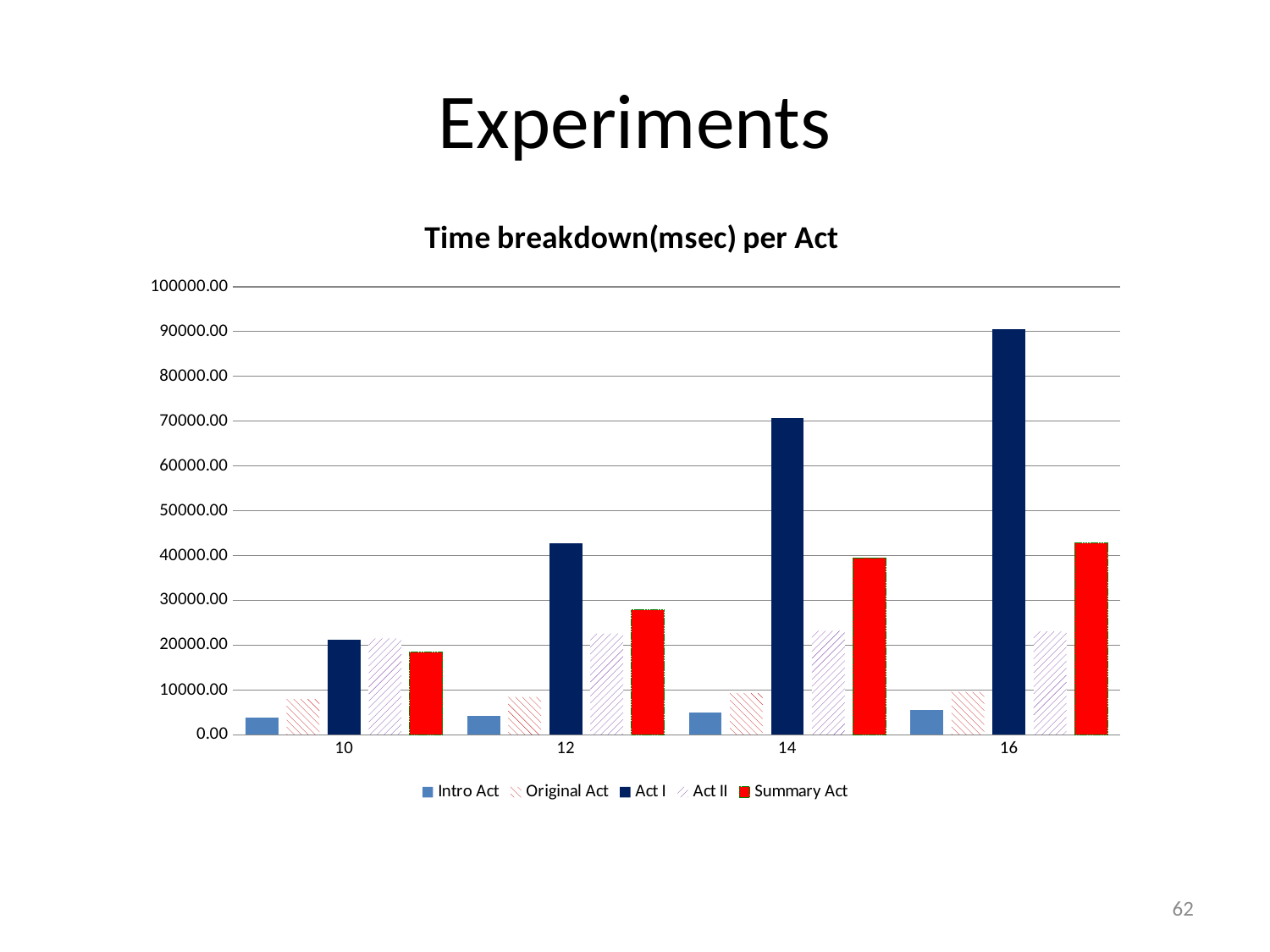
What is the title of the chart? Time breakdown(msec) per Act How many series does the legend list? 5 Is the value for Act I at category 12 greater or less than 40000? greater Which series has the tallest bar in the category 16? Act I Which series has the shortest bar in the category 10? Intro Act What kind of chart is shown on the slide? bar chart Do the Act I values rise or fall as the x axis goes from 10 to 16? rise At category 14, which is larger: Act I or Summary Act? Act I Is the value for Intro Act at category 10 greater or less than 10000? less How many categories are shown on the x axis? 4 Is the value for Summary Act at category 12 greater or less than 30000? less